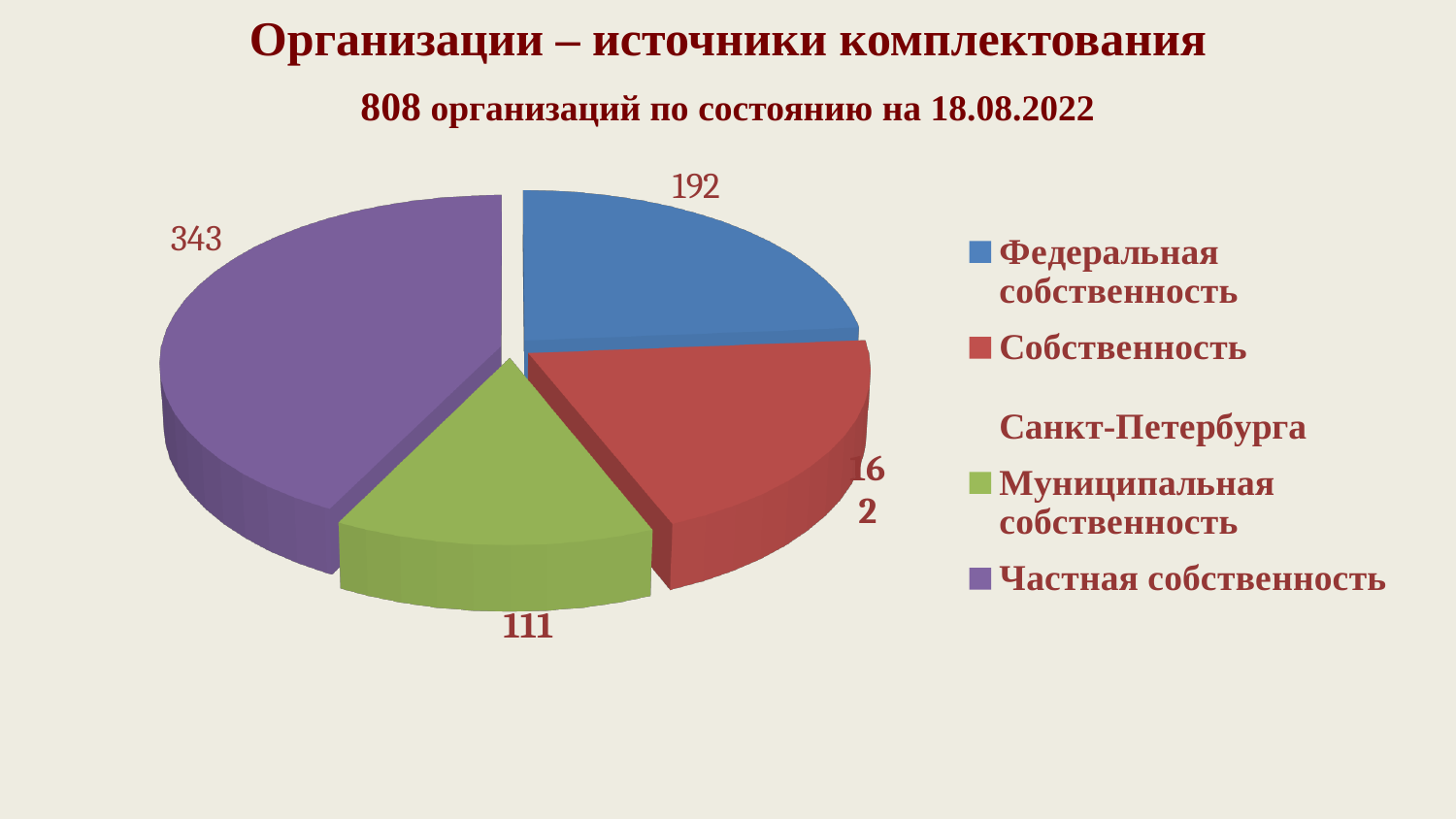
What total number of organisations is stated in the slide subtitle? 808 Which category has the largest slice of the pie? Частная собственность What is the difference between the Федеральная собственность and Муниципальная собственность values? 81 How many categories does the legend list? 4 How many organisations are in the Частная собственность slice? 343 Which is larger, Федеральная собственность or Муниципальная собственность? Федеральная собственность Which category has the smallest slice of the pie? Муниципальная собственность What colour is the Частная собственность slice? Purple How many organisations are in the Федеральная собственность slice? 192 How many organisations are in the Муниципальная собственность slice? 111 What is the difference between the Частная собственность and Федеральная собственность values? 151 What kind of chart is shown on the slide? Pie chart